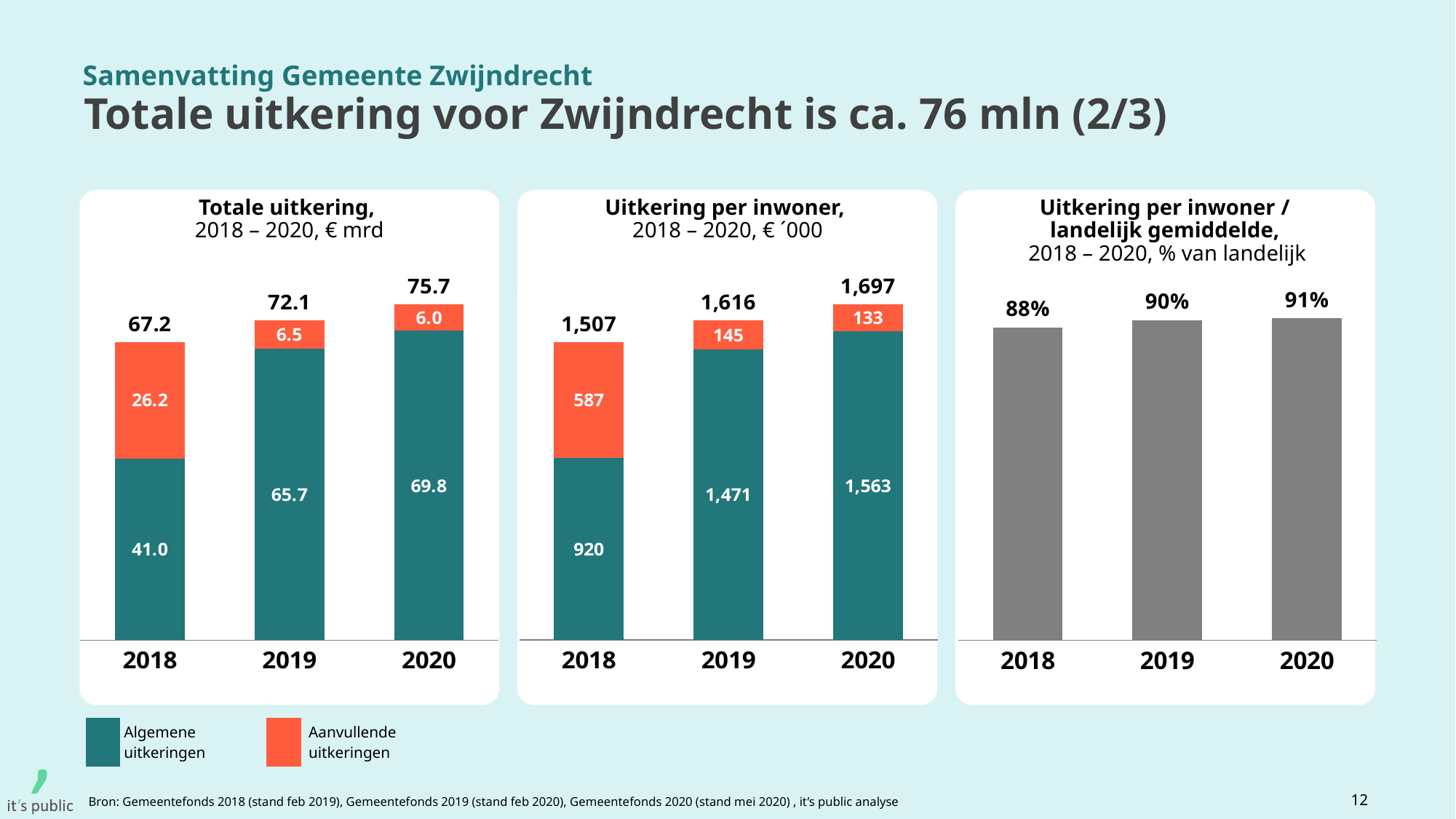
In the 'Uitkering per inwoner / landelijk gemiddelde' chart, which year has the highest value? 2020 How many series does the legend list for the stacked charts? 2 In the 'Totale uitkering' chart, what is the difference between the Aanvullende uitkeringen values for 2018 and 2020? 20.2 In the 'Uitkering per inwoner' chart, which is larger: Aanvullende uitkeringen in 2019 or in 2020? 2019 In the 'Uitkering per inwoner / landelijk gemiddelde' chart, do the values rise or fall from 2018 to 2020? rise In the 'Totale uitkering' chart, what is the total of the stacked bar for 2020? 75.7 In the 'Uitkering per inwoner / landelijk gemiddelde' chart, what is the value for 2019? 90% In the 'Uitkering per inwoner' chart, what is the total for 2018? 1,507 In the 'Totale uitkering' chart, what is the value of Aanvullende uitkeringen for 2019? 6.5 In the 'Totale uitkering' chart, what is the value of Algemene uitkeringen for 2018? 41.0 In the 'Totale uitkering' chart, which year has the lowest total? 2018 In the 'Uitkering per inwoner' chart, what is the value of Algemene uitkeringen for 2020? 1,563